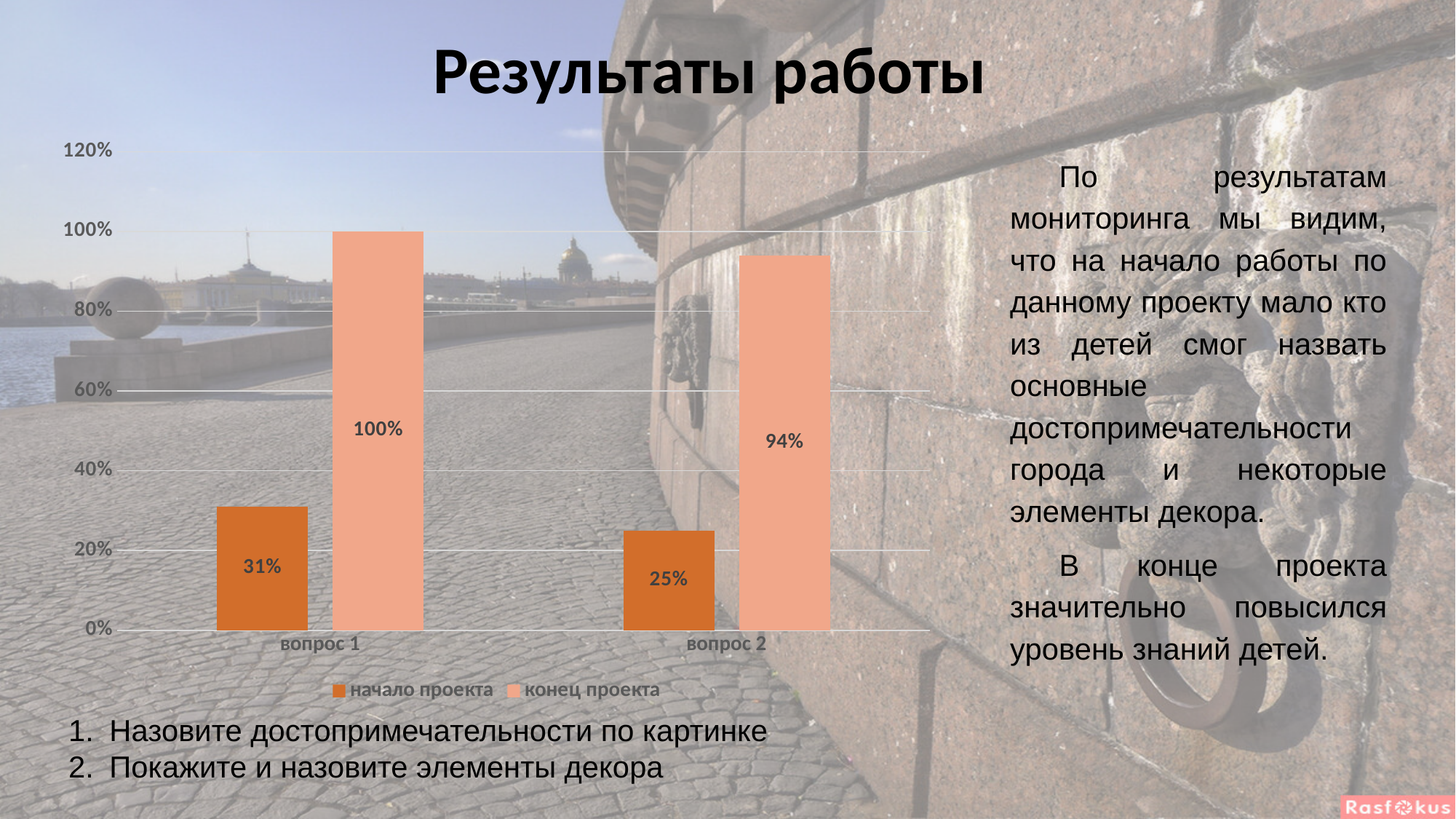
What is the value for 'конец проекта' for 'вопрос 1'? 100% Which is larger: 'начало проекта' for 'вопрос 1' or 'начало проекта' for 'вопрос 2'? вопрос 1 How many categories are shown on the x axis? 2 What kind of chart is shown on the slide? bar chart How many series does the legend list? 2 What is the value for 'начало проекта' for 'вопрос 1'? 31% What is the value for 'начало проекта' for 'вопрос 2'? 25% What is the value for 'конец проекта' for 'вопрос 2'? 94% Which category has the lowest value for 'начало проекта'? вопрос 2 What is the difference between 'конец проекта' and 'начало проекта' for 'вопрос 1'? 69% What is the difference between 'конец проекта' and 'начало проекта' for 'вопрос 2'? 69% Which category has the highest value for 'конец проекта'? вопрос 1